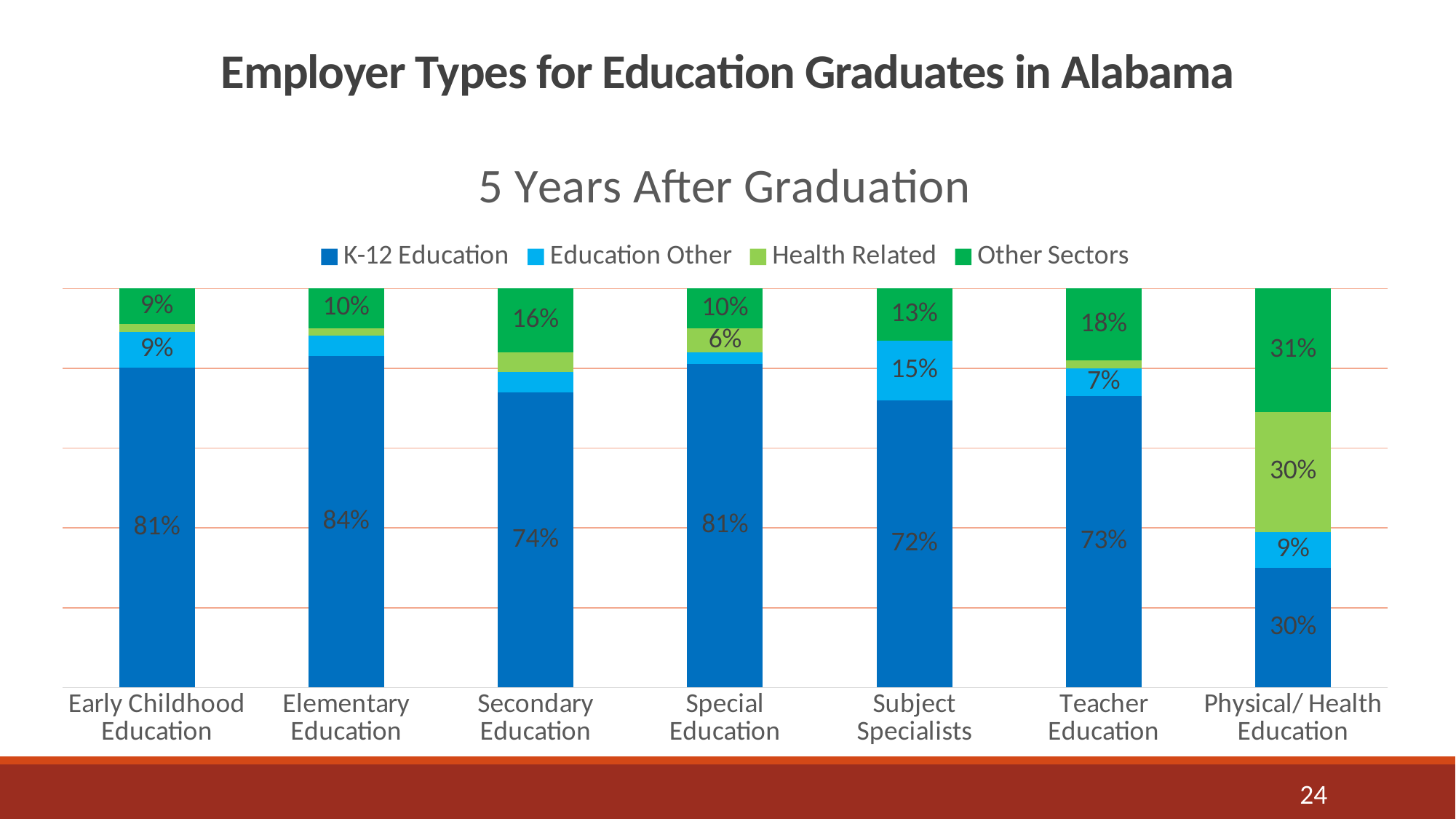
Which has a larger Other Sectors share, Teacher Education or Secondary Education? Teacher Education What is the difference in K-12 Education share between Elementary Education (84%) and Subject Specialists (72%)? 12 percentage points How many series does the legend list? 4 How many program categories are shown on the x axis? 7 What is the Education Other share for Subject Specialists? 15% Which program has the highest K-12 Education share? Elementary Education Which program has the highest Other Sectors share? Physical/ Health Education What percentage of Secondary Education graduates are employed in K-12 Education? 74% What kind of chart is shown on the slide? Stacked bar chart What is the Other Sectors share for Physical/ Health Education graduates? 31% Which program has the lowest K-12 Education share? Physical/ Health Education What is the Health Related share for Special Education graduates? 6%